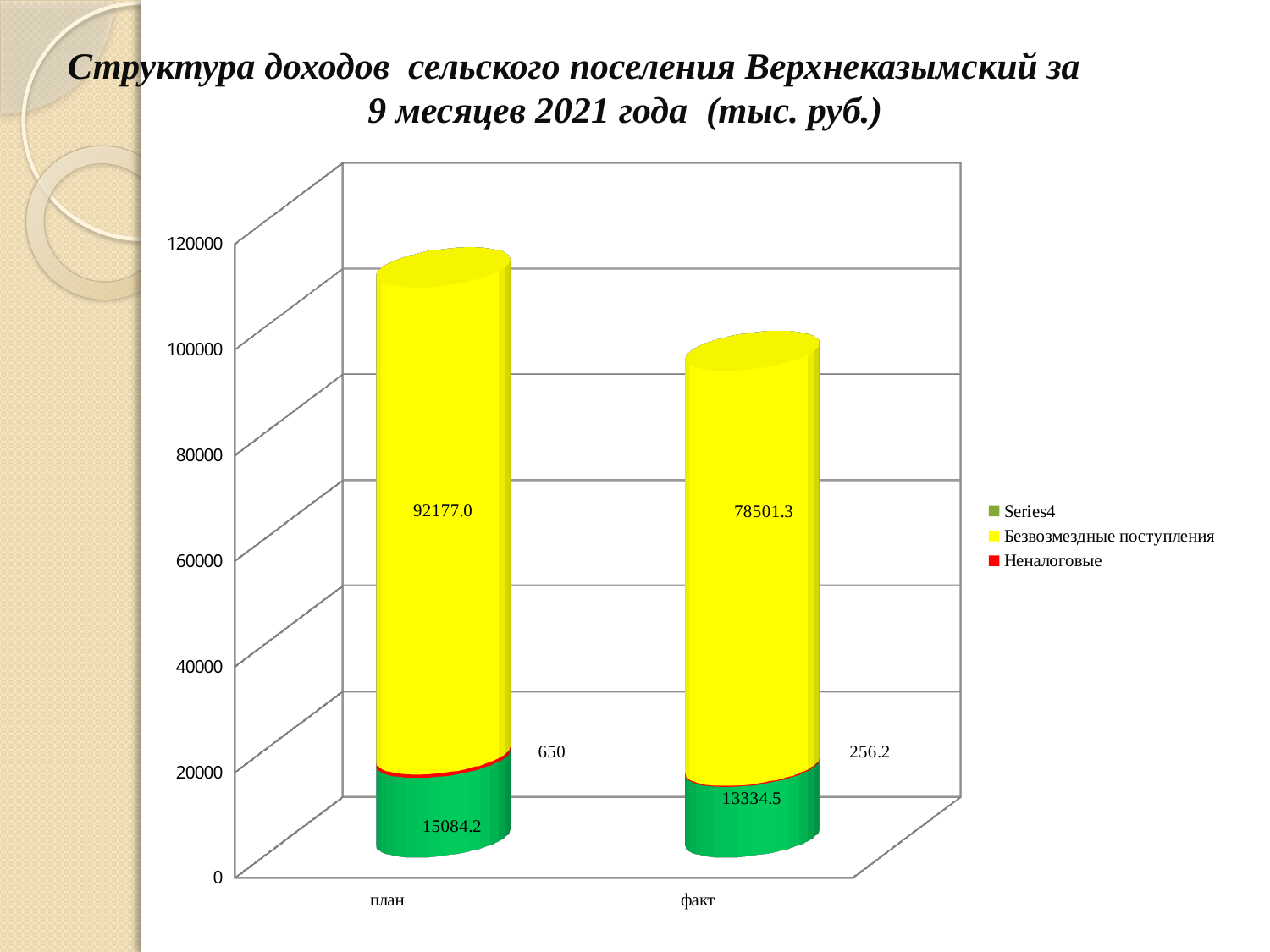
How many categories are shown on the x axis? 2 What is the difference between the Безвозмездные поступления values for план and факт? 13675.7 What kind of chart is shown on the slide? Stacked bar chart What is the value of the green Series4 segment for факт? 13334.5 What is the difference between the Неналоговые values for план and факт? 393.8 What is the total of the stacked bar for план? 107911.2 What is the value of Безвозмездные поступления for план? 92177.0 Which category has the larger Безвозмездные поступления value, план or факт? план How many series does the legend list? 3 What is the value of Неналоговые for план? 650 What is the value of Безвозмездные поступления for факт? 78501.3 What is the value of Неналоговые for факт? 256.2